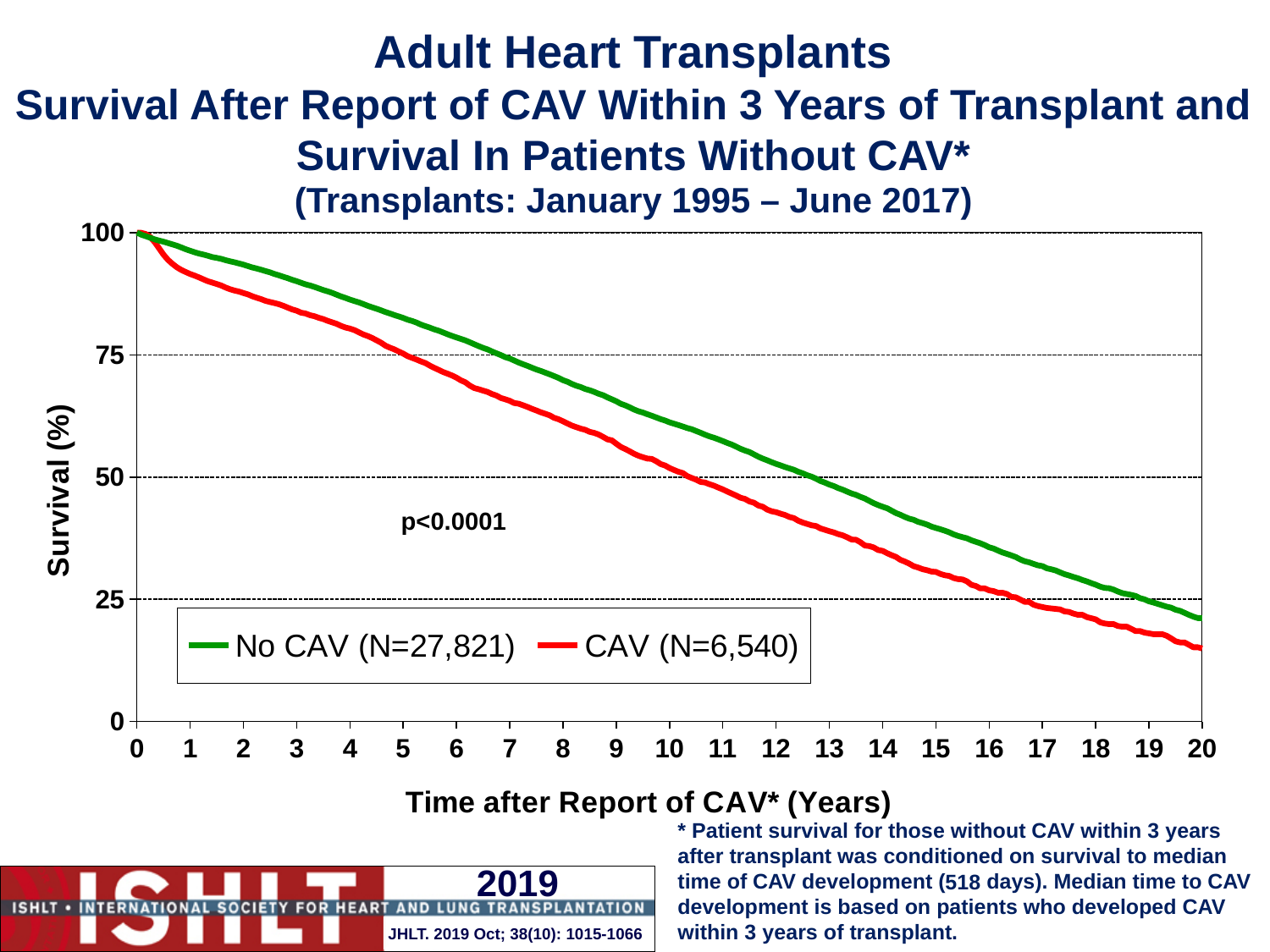
Is the survival value for the CAV series at 20 years greater or less than 25? less Do the survival curves rise or fall as time after report of CAV increases? fall Is the survival value for the No CAV series at 10 years greater or less than 50? greater Is the survival value for the No CAV series at 5 years greater or less than 75? greater What is the survival value for both series at year 0? 100 Which series has higher survival at 10 years, No CAV or CAV? No CAV How many series does the legend list? 2 What kind of chart is shown on the slide? line chart What is the number of patients (N) in the CAV series according to the legend? 6,540 What p-value is printed on the chart? p<0.0001